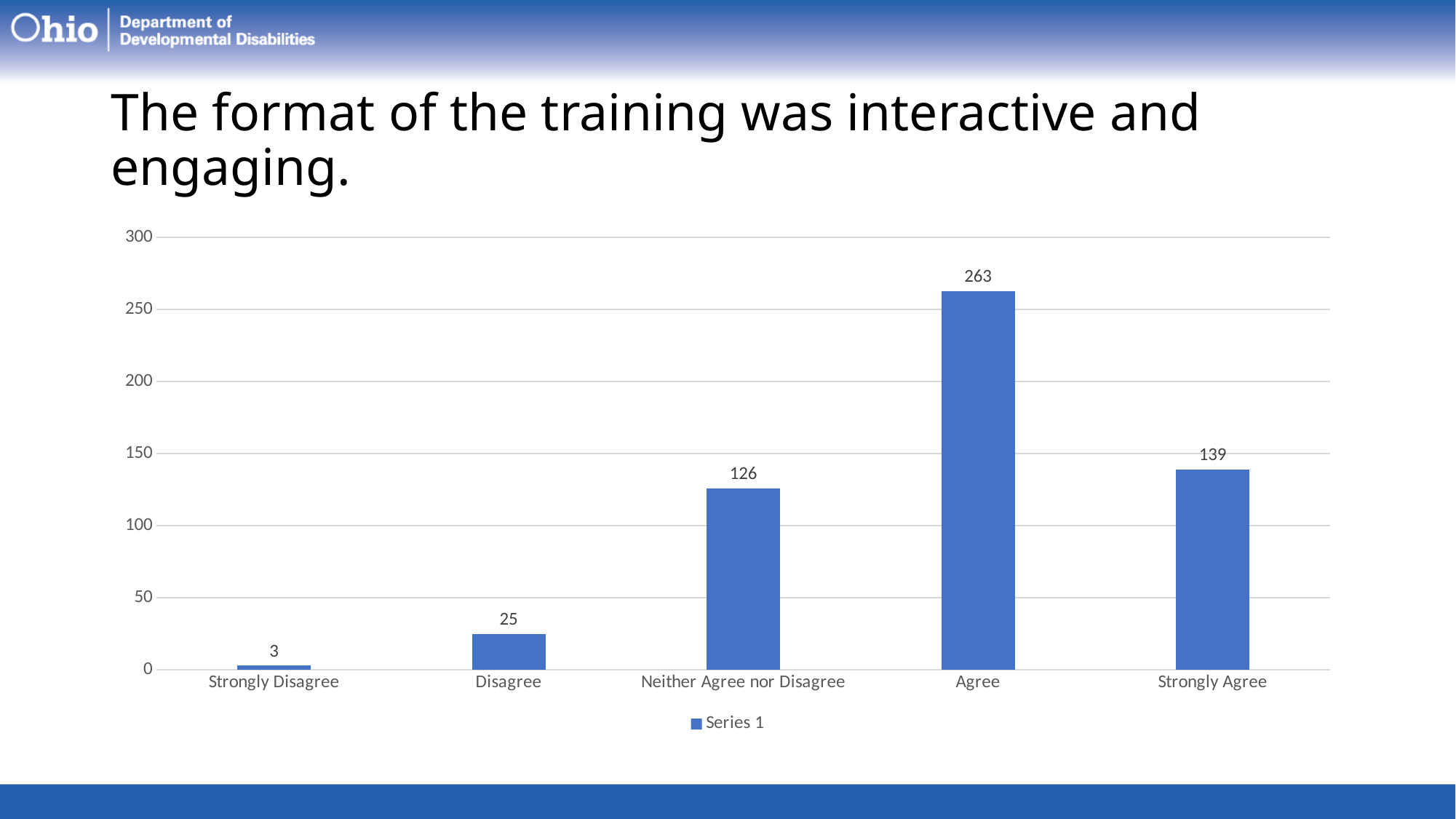
Which is larger, the value for Disagree or the value for Neither Agree nor Disagree? Neither Agree nor Disagree What kind of chart is shown on the slide? bar chart What series name does the legend show? Series 1 How many categories are shown on the x axis? 5 What is the value for Neither Agree nor Disagree? 126 What is the difference between the values for Agree and Strongly Agree? 124 Which category has the highest value? Agree What is the value for Strongly Agree? 139 What is the value for Strongly Disagree? 3 Is the value for Strongly Agree greater or less than 100? greater Which category has the lowest value? Strongly Disagree What is the value for Agree? 263